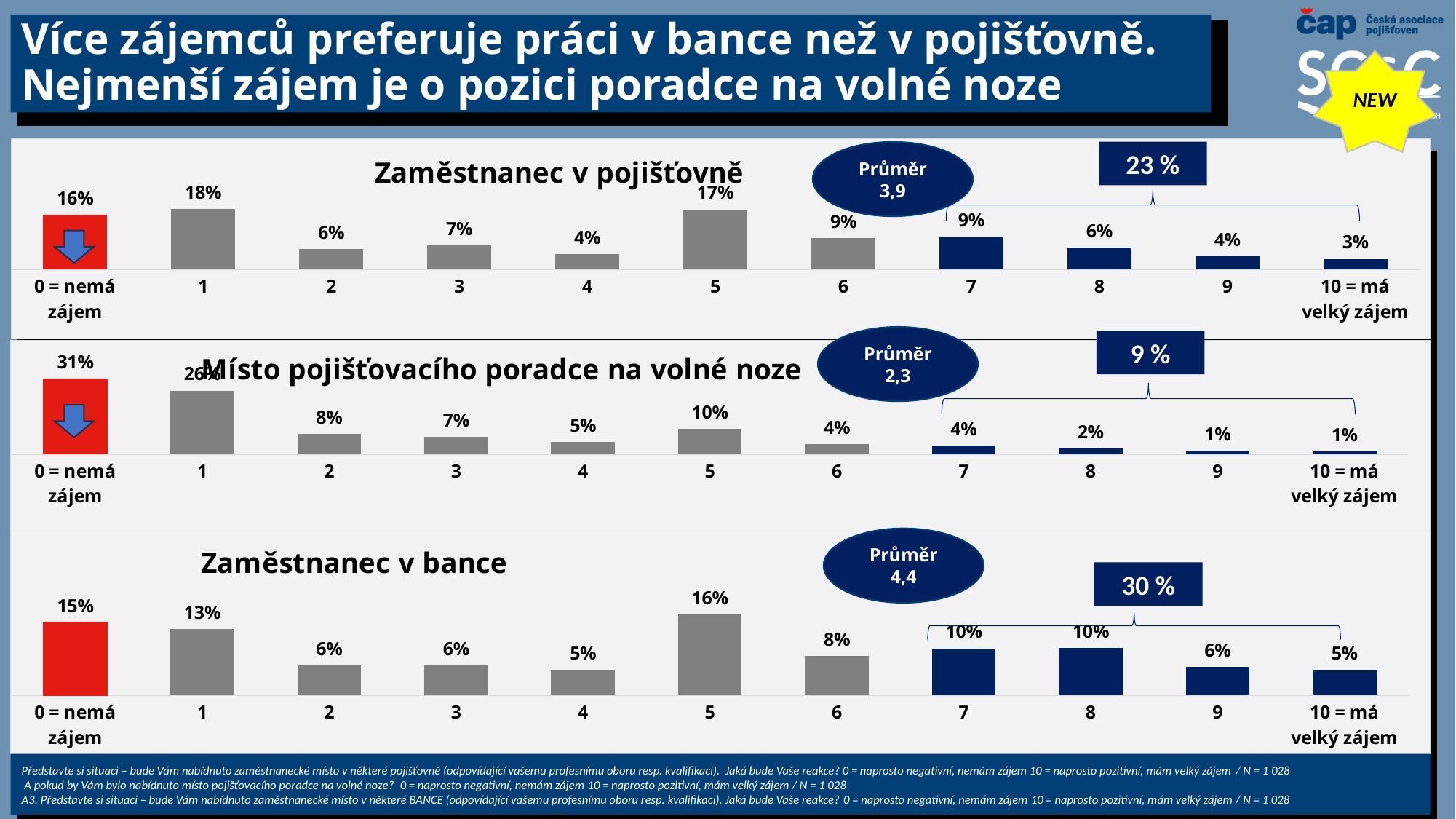
How many categories are plotted in the chart titled "Zaměstnanec v bance"? 11 In the chart titled "Zaměstnanec v pojišťovně", what is the difference between the values for category 0 and category 10? 13% What kind of chart is "Místo pojišťovacího poradce na volné noze"? bar chart What is the average (Průměr) shown for the chart titled "Zaměstnanec v bance"? 4,4 In the chart titled "Zaměstnanec v pojišťovně", what is the value for category 10 (má velký zájem)? 3% In the chart titled "Zaměstnanec v bance", what is the difference between the values for category 5 and category 1? 3% In the chart titled "Místo pojišťovacího poradce na volné noze", what is the value for category 5? 10% In the chart titled "Zaměstnanec v pojišťovně", what is the value for category 1? 18% In the chart titled "Zaměstnanec v bance", which category has the highest value? 5 What percentage is shown in the box above categories 7–10 in the chart titled "Místo pojišťovacího poradce na volné noze"? 9 % In the chart titled "Místo pojišťovacího poradce na volné noze", which category has the highest value? 0 = nemá zájem In the chart titled "Zaměstnanec v bance", which is larger: the value for category 7 or the value for category 9? category 7